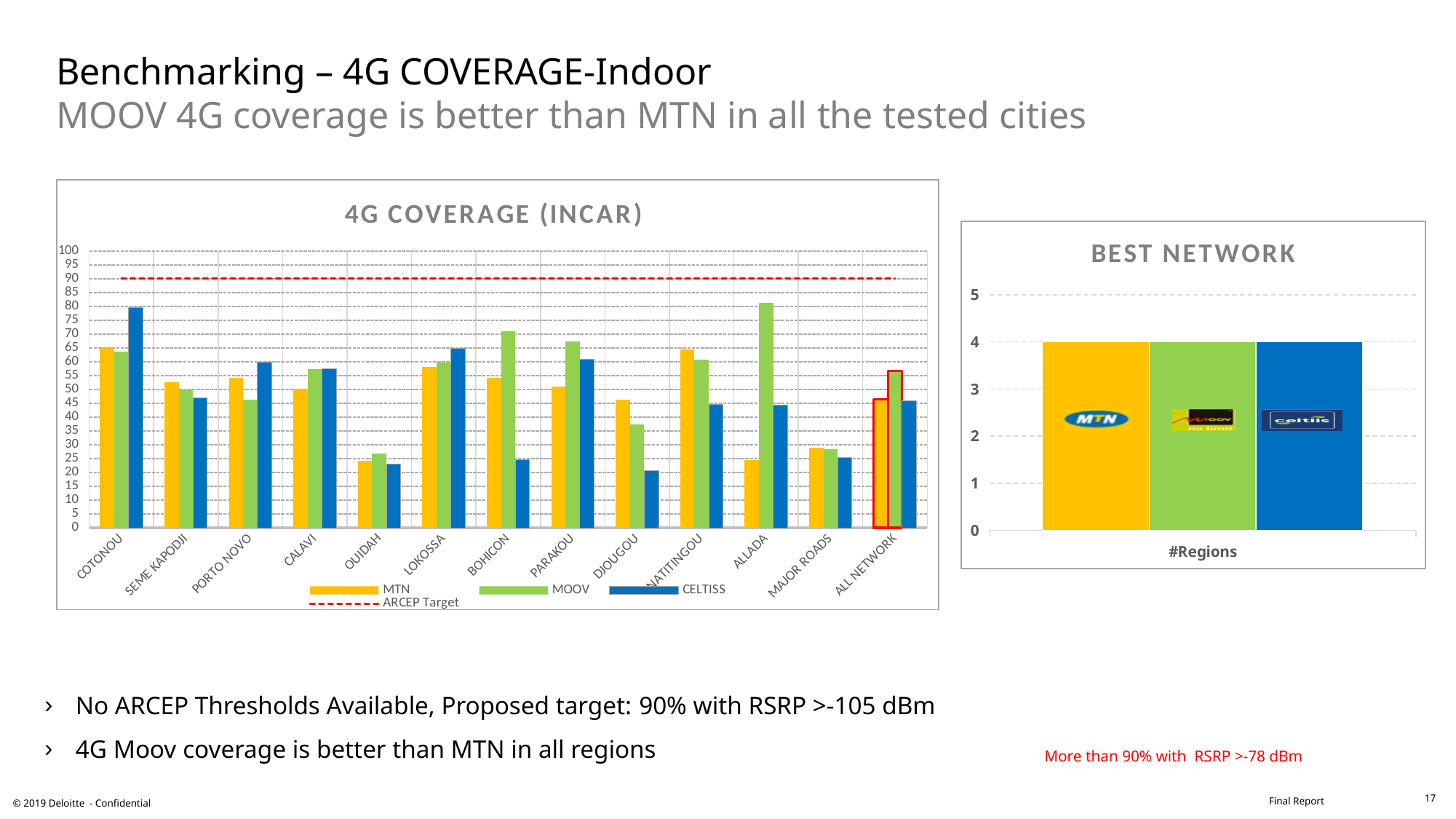
How many bars are shown in the BEST NETWORK chart? 3 In the 4G COVERAGE (INCAR) chart, which series has the highest value for COTONOU? CELTISS How many categories are shown on the x axis of the 4G COVERAGE (INCAR) chart? 13 How many entries does the legend of the 4G COVERAGE (INCAR) chart list? 4 In the BEST NETWORK chart, what is the value of the MTN bar? 4 In the 4G COVERAGE (INCAR) chart, is the MTN value for OUIDAH greater or less than 30? less In the 4G COVERAGE (INCAR) chart, is the MOOV value for ALLADA greater or less than 75? greater In the 4G COVERAGE (INCAR) chart, which is larger for DJOUGOU, the MTN value or the CELTISS value? MTN In the 4G COVERAGE (INCAR) chart, which series has the highest value for ALLADA? MOOV What kind of chart is the 4G COVERAGE (INCAR) chart? bar chart In the 4G COVERAGE (INCAR) chart, at what value is the ARCEP Target dashed line drawn? 90 In the 4G COVERAGE (INCAR) chart, is the CELTISS value for COTONOU greater or less than 70? greater